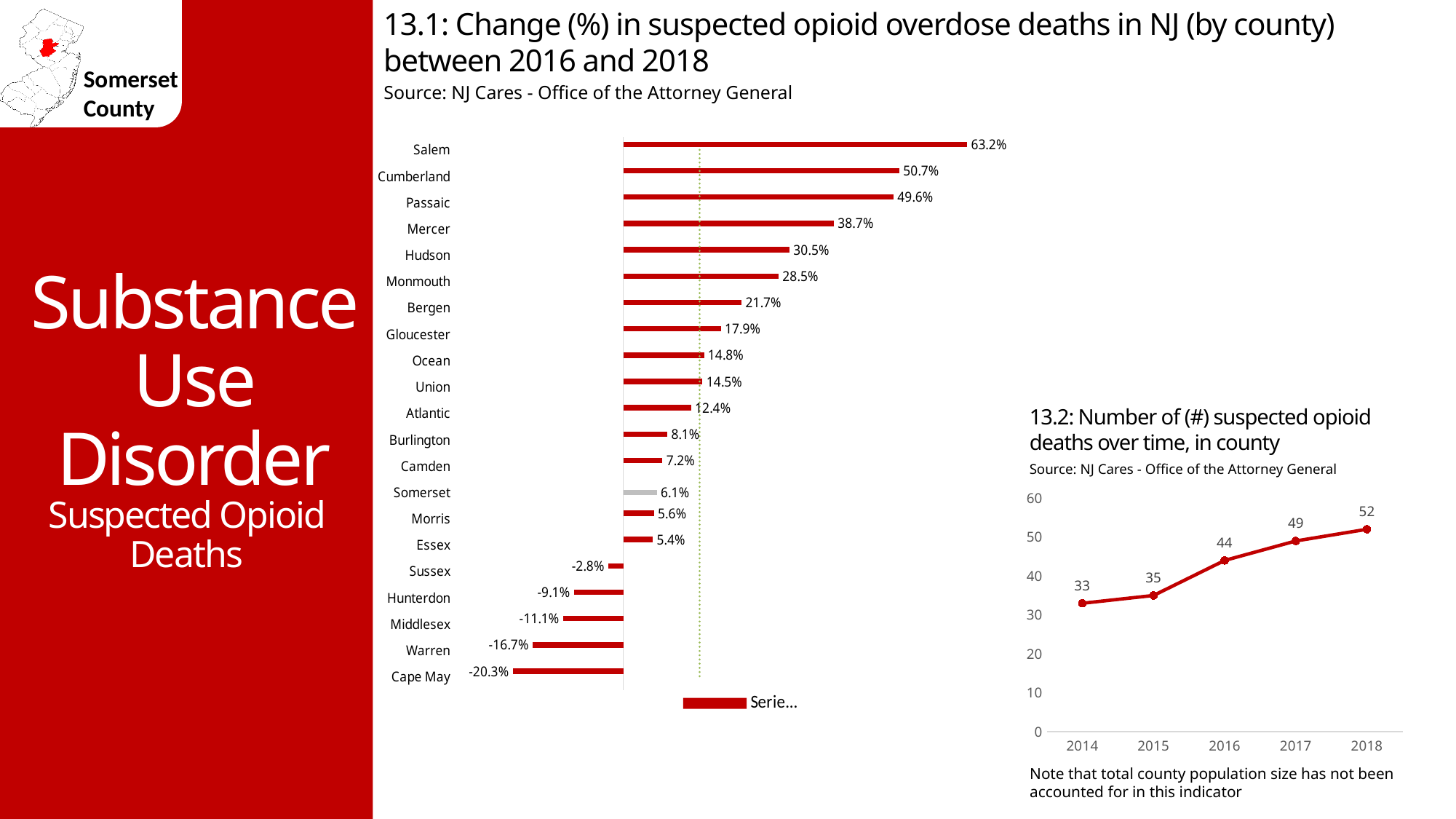
In chart 13.1, what is the value for Hudson? 30.5% In chart 13.1, what is the difference between the values for Salem and Cumberland? 12.5% In chart 13.1, how many counties are shown? 21 In chart 13.1 (Change (%) in suspected opioid overdose deaths in NJ by county), what is the value for Somerset? 6.1% In chart 13.2 (Number of suspected opioid deaths over time, in county), what is the value for 2016? 44 In chart 13.1, which county has the highest change in suspected opioid overdose deaths? Salem In chart 13.2, do the values rise or fall from 2014 to 2018? Rise In chart 13.1, which county has the lowest change in suspected opioid overdose deaths? Cape May What kind of chart is chart 13.1? Bar chart In chart 13.1, which county has the larger value, Mercer or Monmouth? Mercer In chart 13.2, what is the difference between the values for 2018 and 2014? 19 In chart 13.2, how many years are plotted? 5